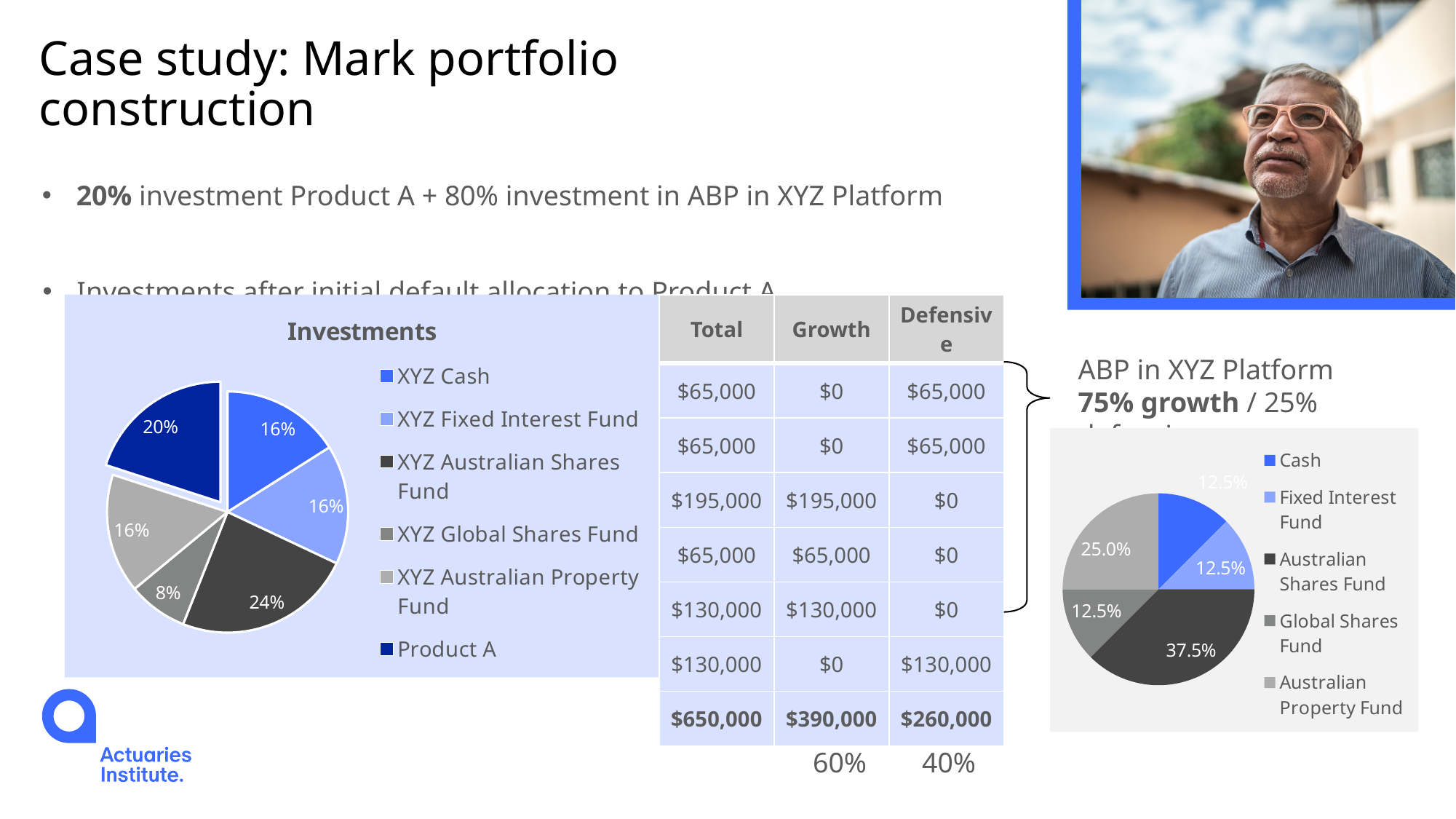
In the Investments pie chart, what share does XYZ Australian Shares Fund have? 24% In the Investments pie chart, what share does Product A have? 20% In the Investments pie chart, what is the difference between the shares of XYZ Australian Shares Fund and XYZ Global Shares Fund? 16% What type of chart is the Investments chart? Pie chart In the pie chart on the right of the slide, which category has the largest slice? Australian Shares Fund In the Investments pie chart, which category has the smallest slice? XYZ Global Shares Fund In the Investments pie chart, what share does XYZ Global Shares Fund have? 8% How many slices does the Investments pie chart have? 6 In the pie chart on the right of the slide, what share does Australian Shares Fund have? 37.5% In the pie chart on the right of the slide, what share does Australian Property Fund have? 25.0% How many entries does the legend of the pie chart on the right of the slide list? 5 In the Investments pie chart, which category has the largest slice? XYZ Australian Shares Fund